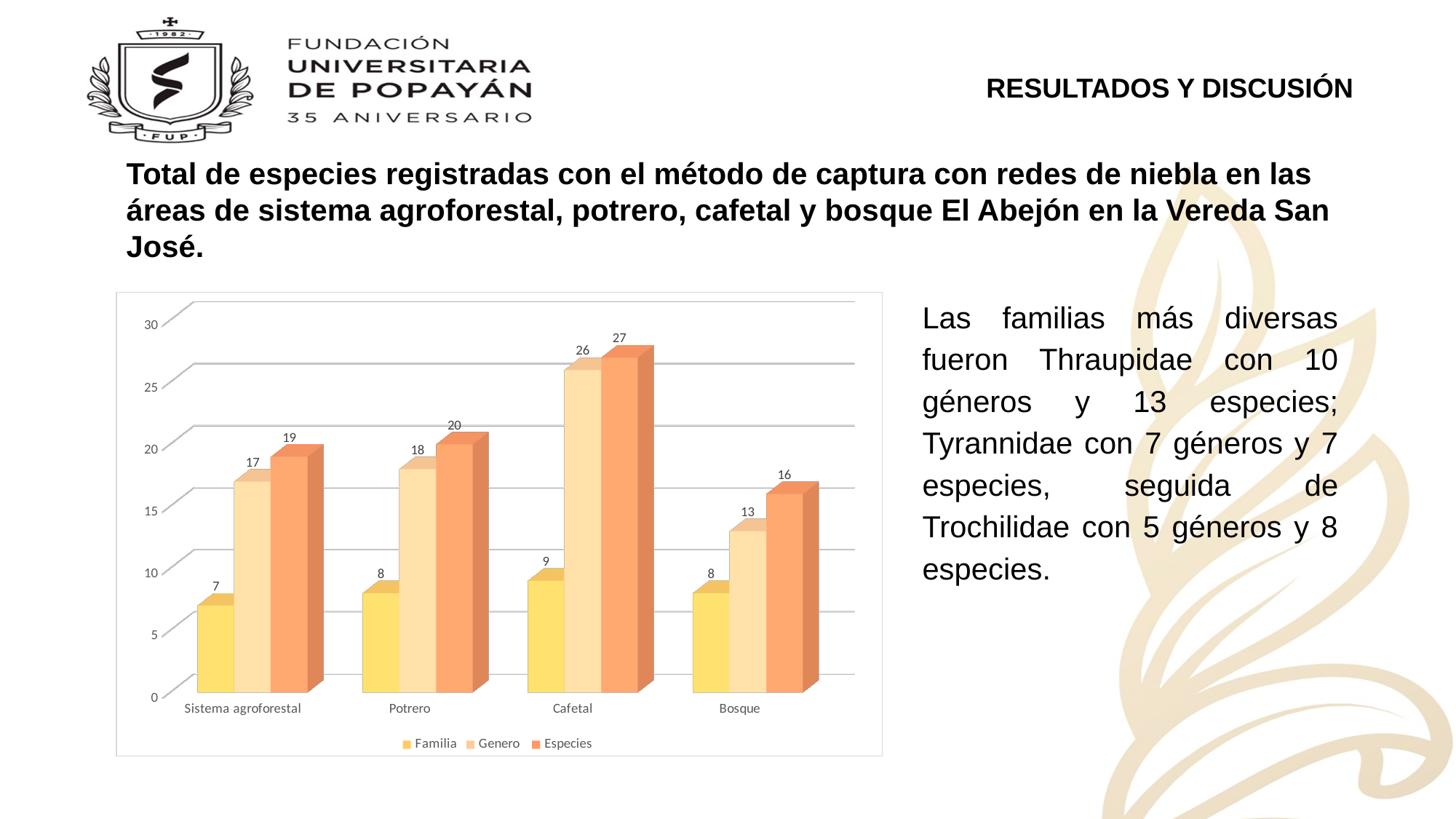
What is the difference between the Genero and Familia values for Cafetal? 17 What is the value of Especies for Cafetal? 27 Which category has the lowest Genero value? Bosque What is the difference between the Especies values for Cafetal and Bosque? 11 Which is larger, the Genero value for Sistema agroforestal or the Genero value for Potrero? Potrero What kind of chart is shown on the slide? Bar chart What is the value of Genero for Potrero? 18 What are the three series listed in the legend? Familia, Genero, Especies What is the value of Familia for Sistema agroforestal? 7 How many categories are shown on the x axis? 4 Which category has the highest Especies value? Cafetal How many series does the legend list? 3